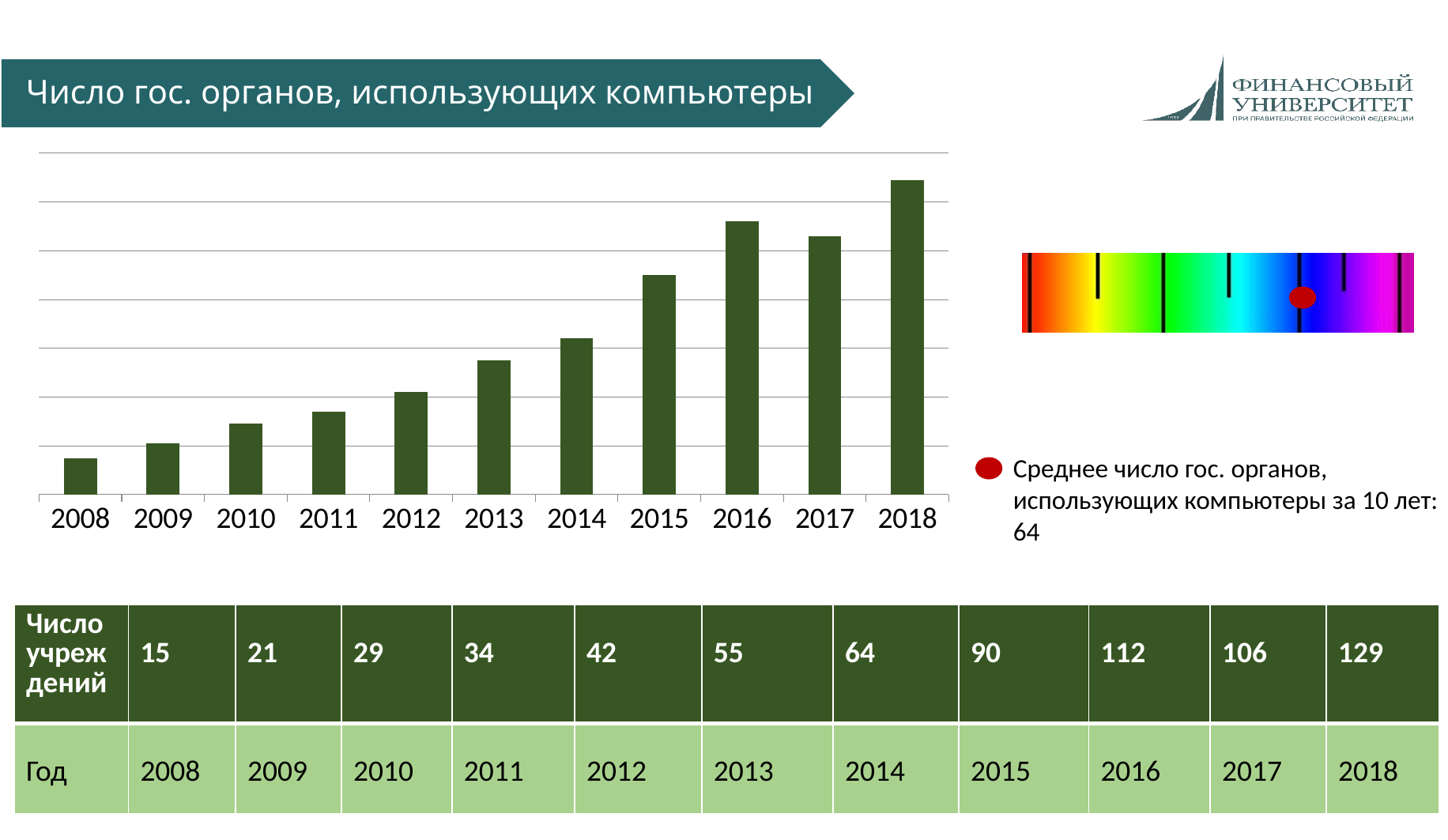
What kind of chart is this? bar chart What is the title of the chart? Число гос. органов, использующих компьютеры Do the values generally rise or fall from 2008 to 2018? rise What is the difference between the values for 2016 and 2017? 6 Which is larger, the value for 2016 or the value for 2017? 2016 Which year has the lowest value? 2008 Which year has the highest value? 2018 What is the value for 2015? 90 What is the value for 2017? 106 What is the difference between the values for 2018 and 2008? 114 What is the value for 2008? 15 How many years are shown on the x axis? 11